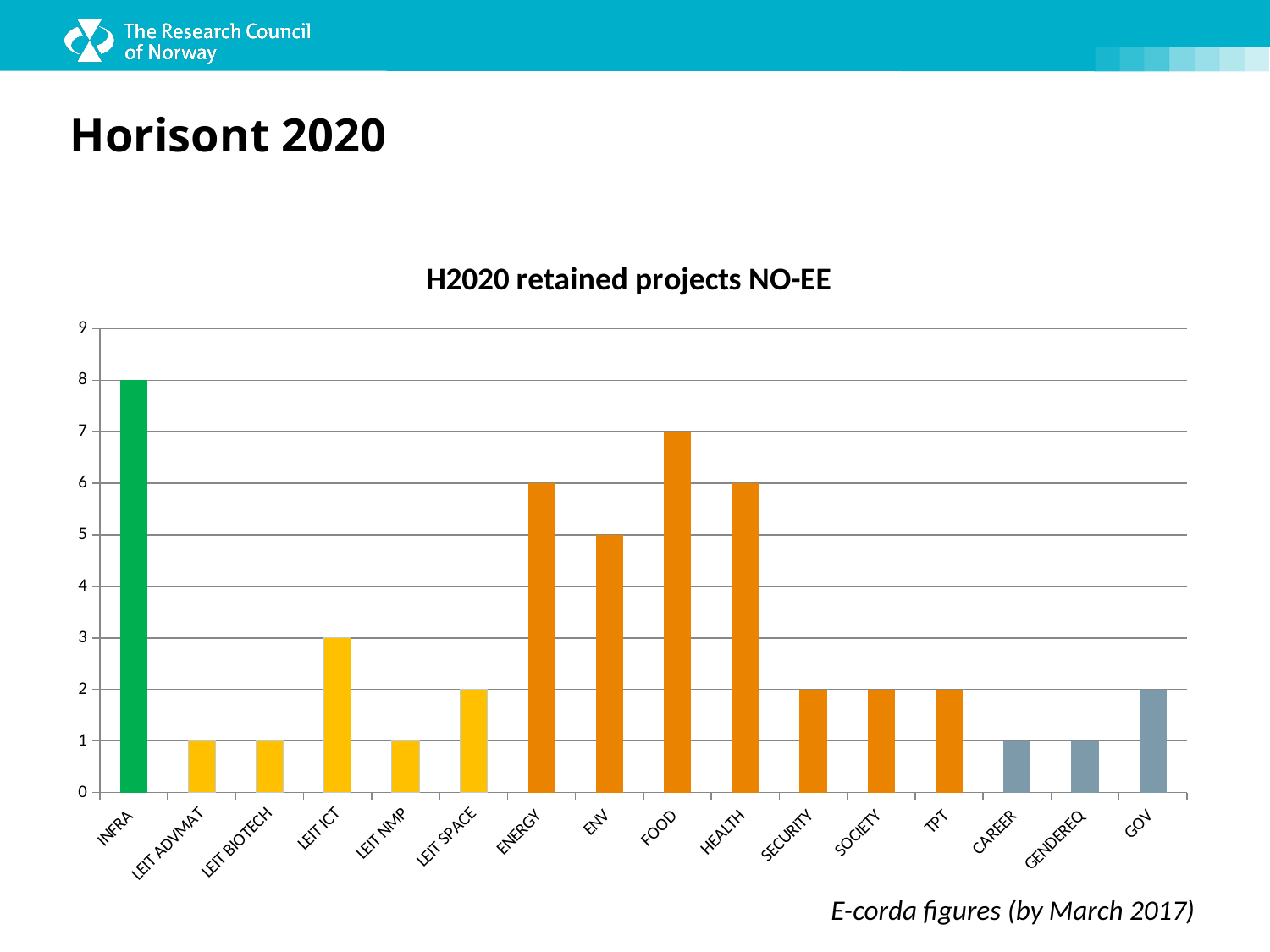
What kind of chart is shown on the slide? bar chart What is the value for INFRA in the H2020 retained projects NO-EE chart? 8 What is the value for ENV? 5 What is the value for FOOD? 7 What is the difference between the values for ENERGY and LEIT ICT? 3 What is the difference between the values for INFRA and FOOD? 1 Is the value for FOOD greater or less than 5? greater What is the value for LEIT ICT? 3 What is the title of the chart? H2020 retained projects NO-EE Which is larger, the value for ENV or the value for HEALTH? HEALTH Which category has the highest value? INFRA How many categories are shown on the x axis? 16